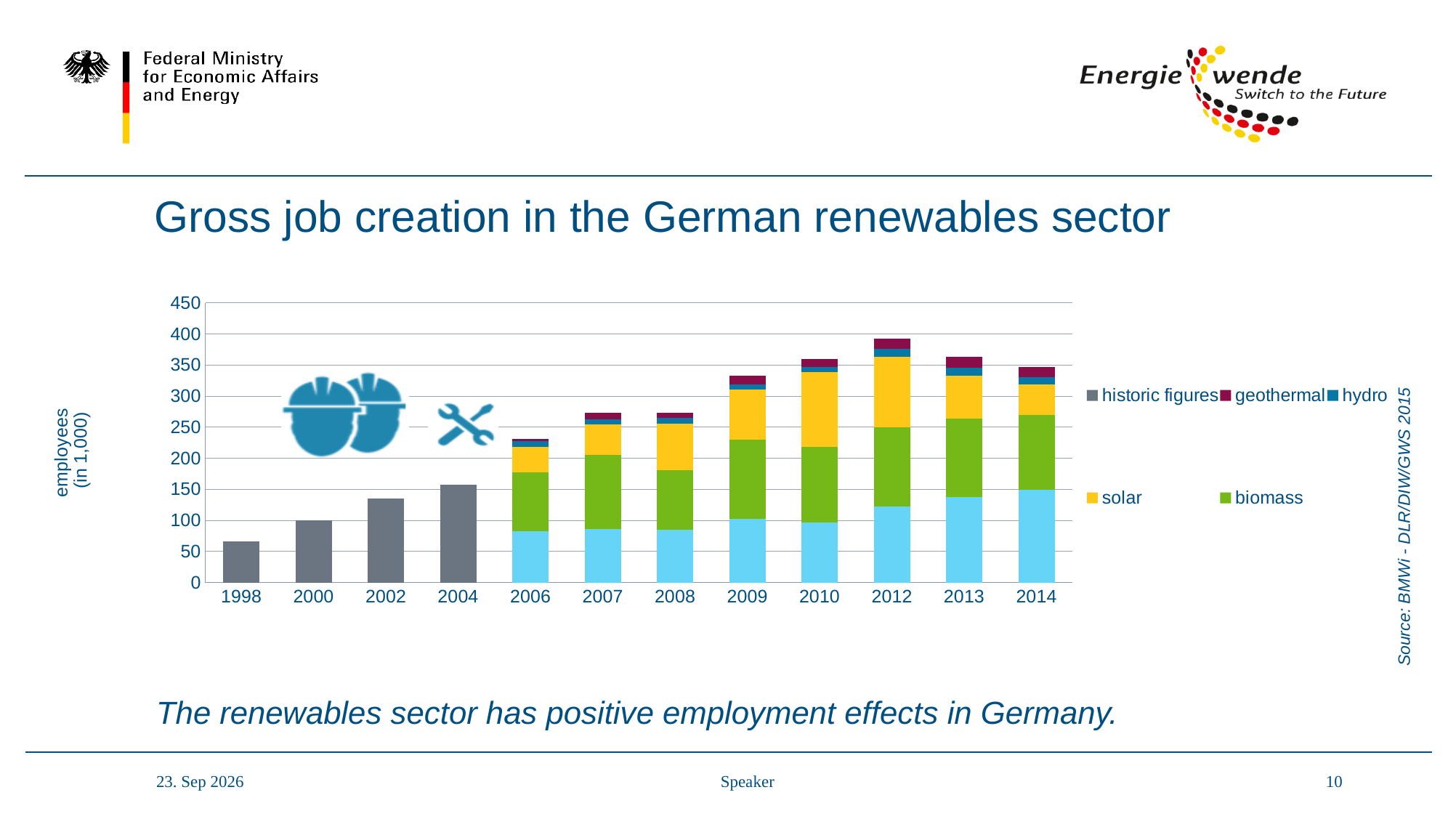
Which year has the taller bar, 2012 or 2014? 2012 Is the total bar height for 2012 greater or less than 350? greater What is the label on the vertical axis of the chart? employees (in 1,000) Is the value for 2004 greater or less than 150? greater Which year has the tallest bar in the chart? 2012 Do the historic figures bars rise or fall from 1998 to 2004? rise How many series does the chart's legend list? 5 Which year has the shortest bar in the chart? 1998 Is the total bar height for 2006 greater or less than 250? less What kind of chart is shown on the slide? stacked bar chart How many years are shown on the x axis of the chart? 12